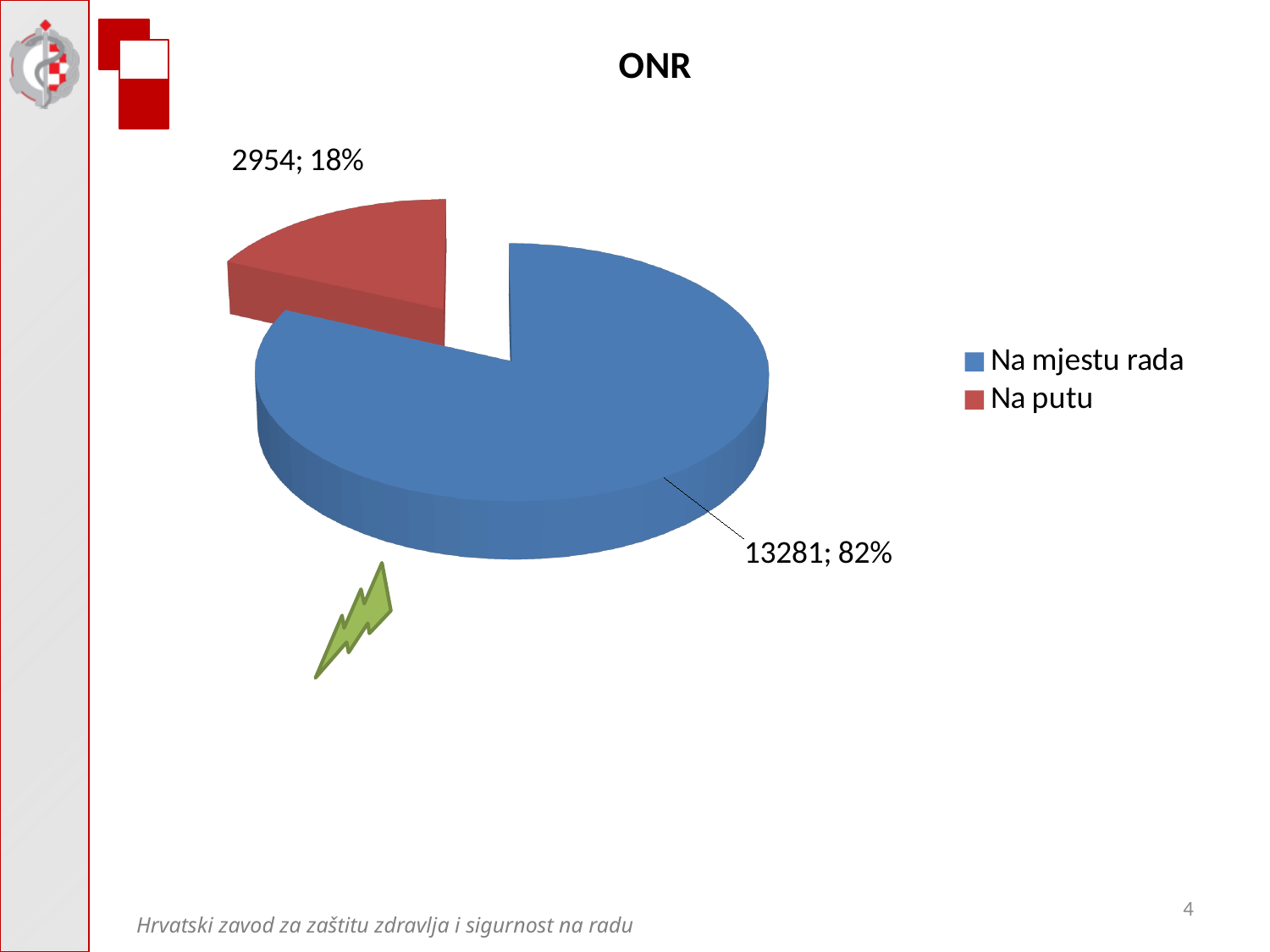
What is the value for Na mjestu rada? 13281 What is the value for Na putu? 2954 What share of the pie does Na mjestu rada represent? 82% Which category has the smallest slice? Na putu How many entries does the legend list? 2 Which category has the largest slice? Na mjestu rada What share of the pie does Na putu represent? 18% Which colour represents Na putu in the chart? red How many slices does the pie chart have? 2 What type of chart is shown on the slide? pie chart What is the title of the chart? ONR What is the difference between the values for Na mjestu rada and Na putu? 10327